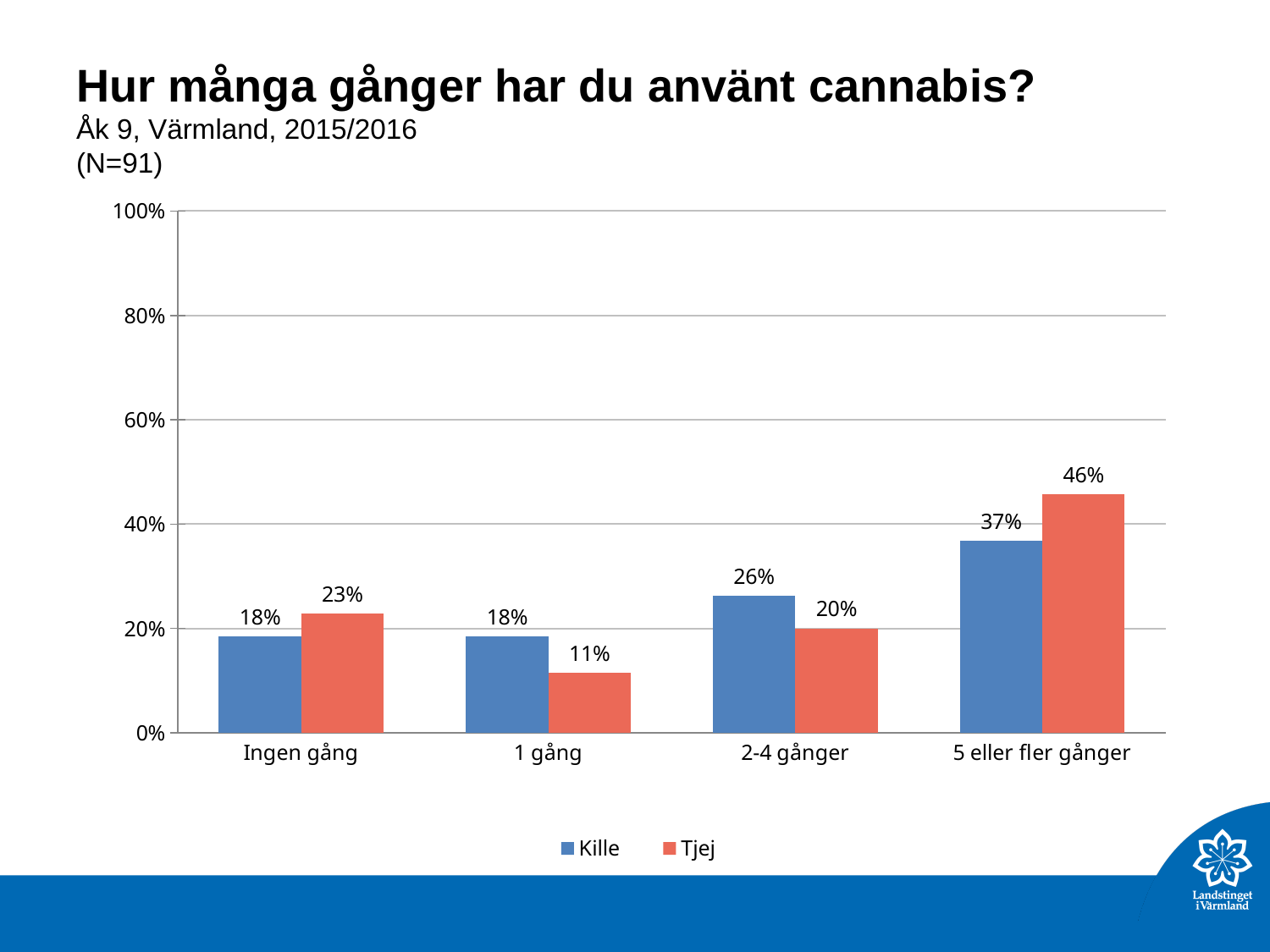
Which category has the highest value for Kille? 5 eller fler gånger What are the two series named in the legend? Kille and Tjej What kind of chart is shown on the slide? Bar chart What is the value for Tjej in the "1 gång" category? 11% What is the value for Tjej in the "5 eller fler gånger" category? 46% Which category has the lowest value for Tjej? 1 gång How many categories are shown on the x axis? 4 What is the difference between Tjej and Kille in the "5 eller fler gånger" category? 9% In the "2-4 gånger" category, which series has the larger value, Kille or Tjej? Kille Is the value for Tjej in the "5 eller fler gånger" category greater or less than 40%? greater What is the value for Kille in the "Ingen gång" category? 18% How many series does the legend list? 2